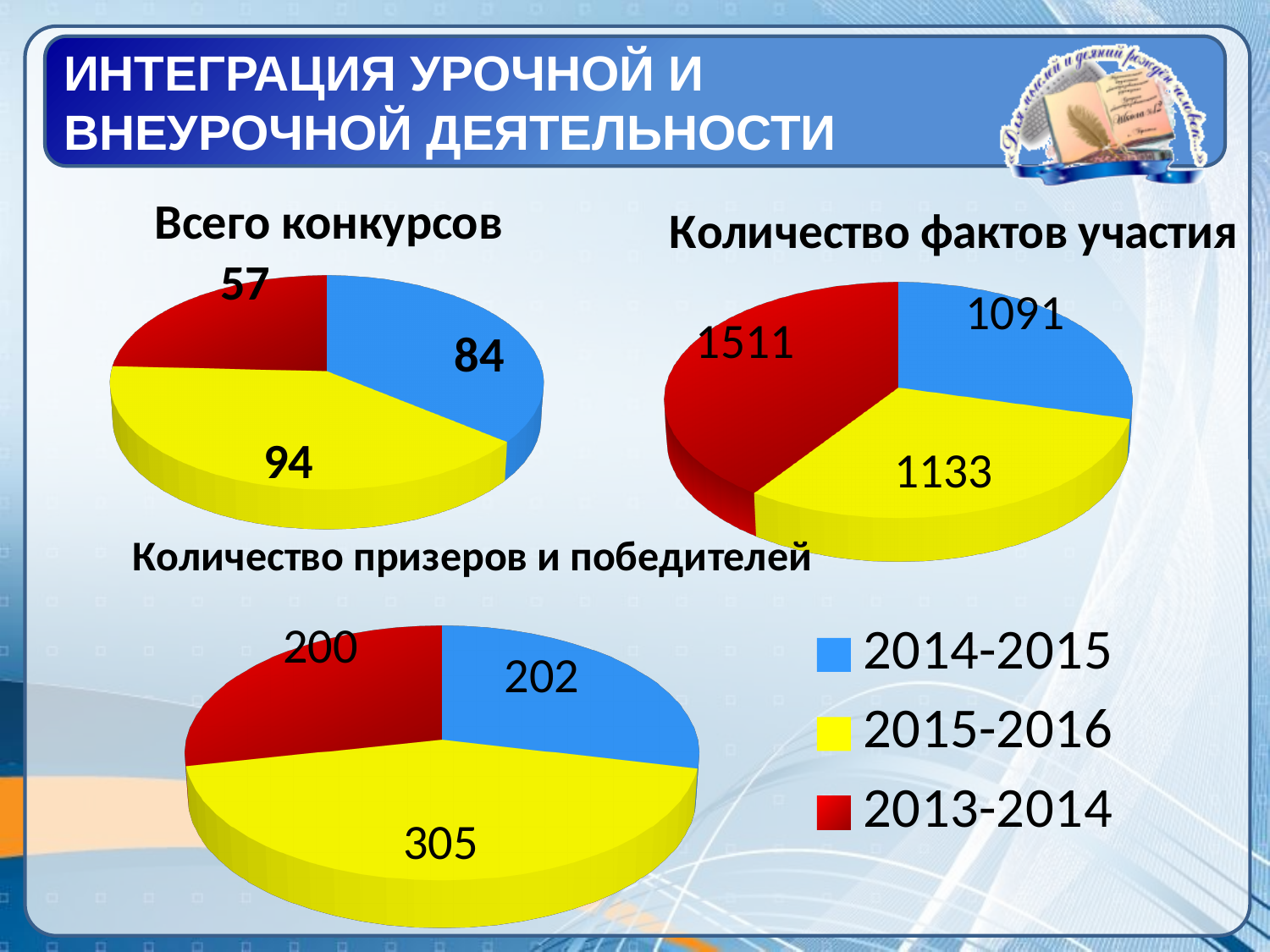
In the chart titled 'Количество фактов участия', which is larger: the value for 2013-2014 or the value for 2015-2016? 2013-2014 In the chart titled 'Количество призеров и победителей', what is the value for 2015-2016? 305 What type of chart is the chart titled 'Всего конкурсов'? Pie chart In the chart titled 'Количество фактов участия', what is the value for 2014-2015? 1091 In the chart titled 'Всего конкурсов', what is the difference between the values for 2015-2016 and 2014-2015? 10 In the chart titled 'Количество призеров и победителей', which year has the largest slice? 2015-2016 In the chart titled 'Всего конкурсов', what is the value for 2015-2016? 94 In the chart titled 'Всего конкурсов', which year has the smallest slice? 2013-2014 In the chart titled 'Всего конкурсов', what is the value for 2013-2014? 57 How many slices does the chart titled 'Количество призеров и победителей' have? 3 In the chart titled 'Количество фактов участия', which year has the largest slice? 2013-2014 In the chart titled 'Количество фактов участия', what is the value for 2013-2014? 1511